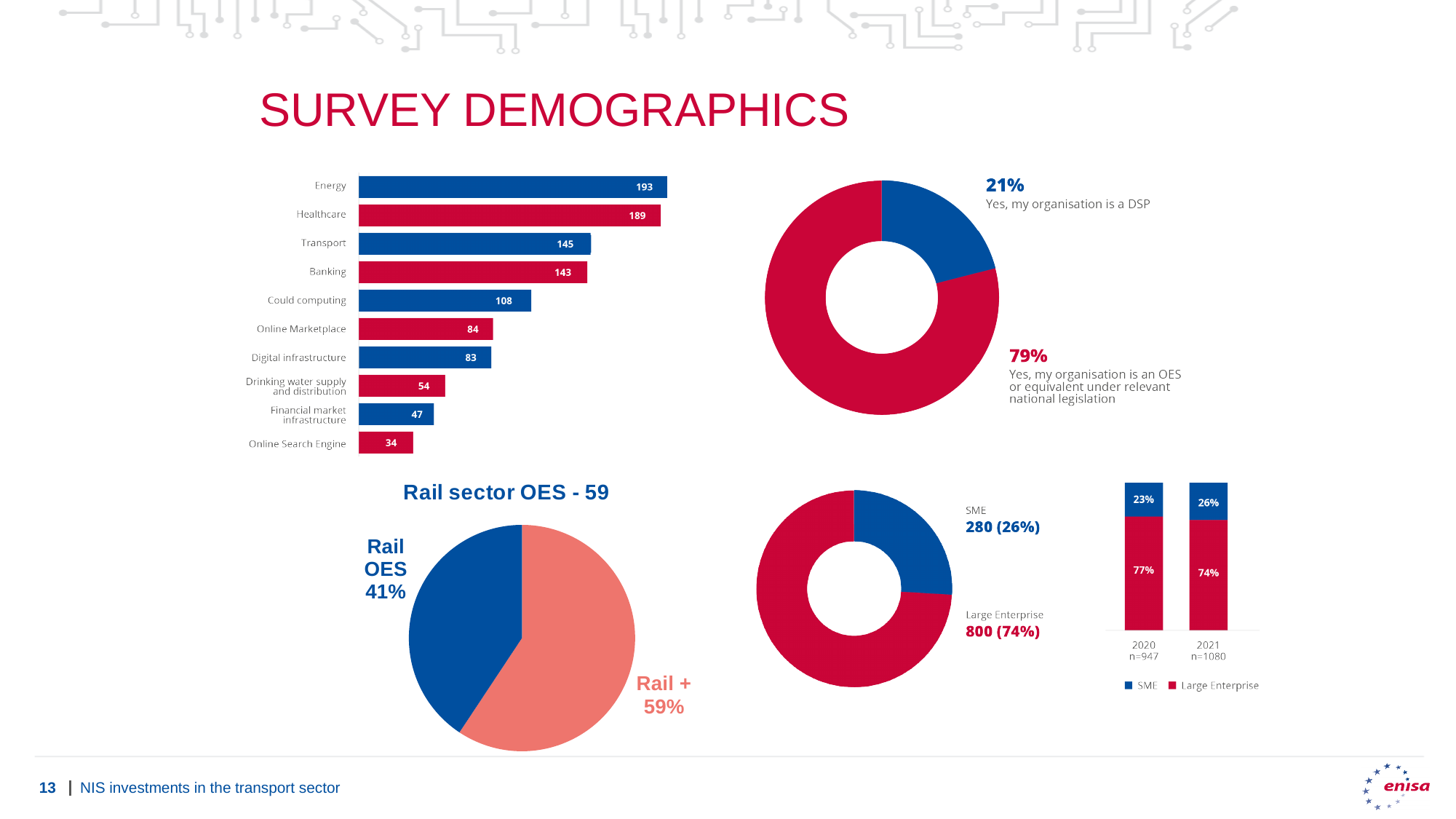
In the horizontal bar chart at the top left, how many categories are shown? 10 What type of chart is the 'Rail sector OES - 59' chart at the bottom left? Pie chart In the horizontal bar chart at the top left, what is the value for Transport? 145 In the donut chart at the top right, what percentage of respondents said their organisation is a DSP? 21% In the pie chart titled 'Rail sector OES - 59', what share is Rail +? 59% In the donut chart at the bottom middle, what is the value for Large Enterprise? 800 (74%) How many series does the legend of the stacked bar chart at the bottom right list? 2 In the stacked bar chart at the bottom right, what is the SME percentage for 2021? 26% In the horizontal bar chart at the top left, which category has the highest value? Energy In the horizontal bar chart at the top left, what is the difference between the values for Energy and Healthcare? 4 In the horizontal bar chart at the top left, which is larger: Could computing or Online Marketplace? Could computing In the horizontal bar chart at the top left, which category has the lowest value? Online Search Engine